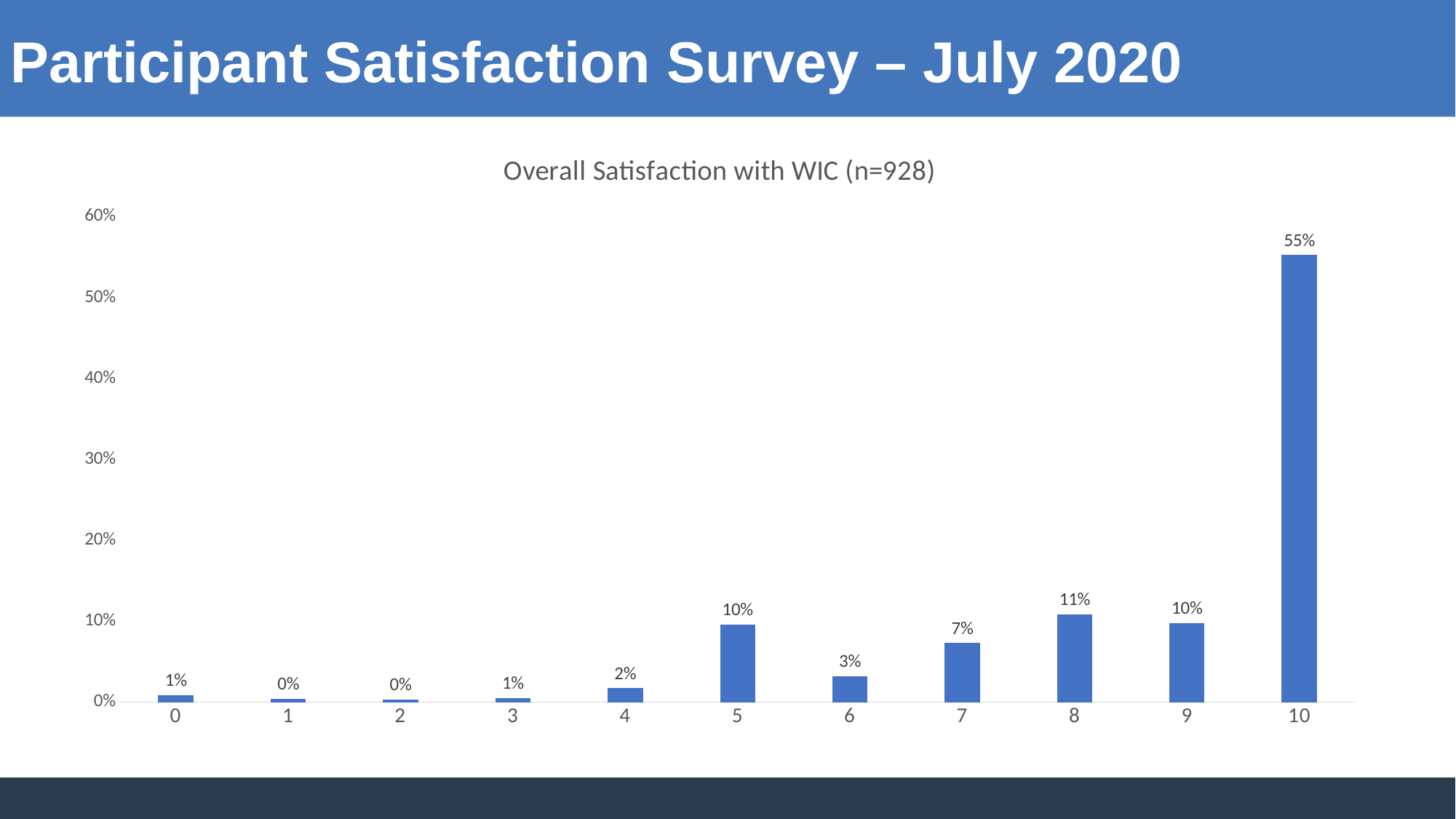
Is the value for the rating of 10 greater or less than 50%? greater What kind of chart is shown on the slide? Bar chart What is the title of the chart? Overall Satisfaction with WIC (n=928) What is the highest value shown on the y axis? 60% What percentage of respondents gave a rating of 8? 11% What percentage of respondents gave a rating of 6? 3% What is the difference in percentage points between the rating of 7 and the rating of 4? 5% What percentage of respondents gave a rating of 10? 55% What is the difference in percentage points between the rating of 10 and the rating of 8? 44% How many rating categories are shown on the x axis? 11 Which has a larger percentage of respondents, a rating of 7 or a rating of 9? 9 Which rating has the highest percentage of respondents? 10